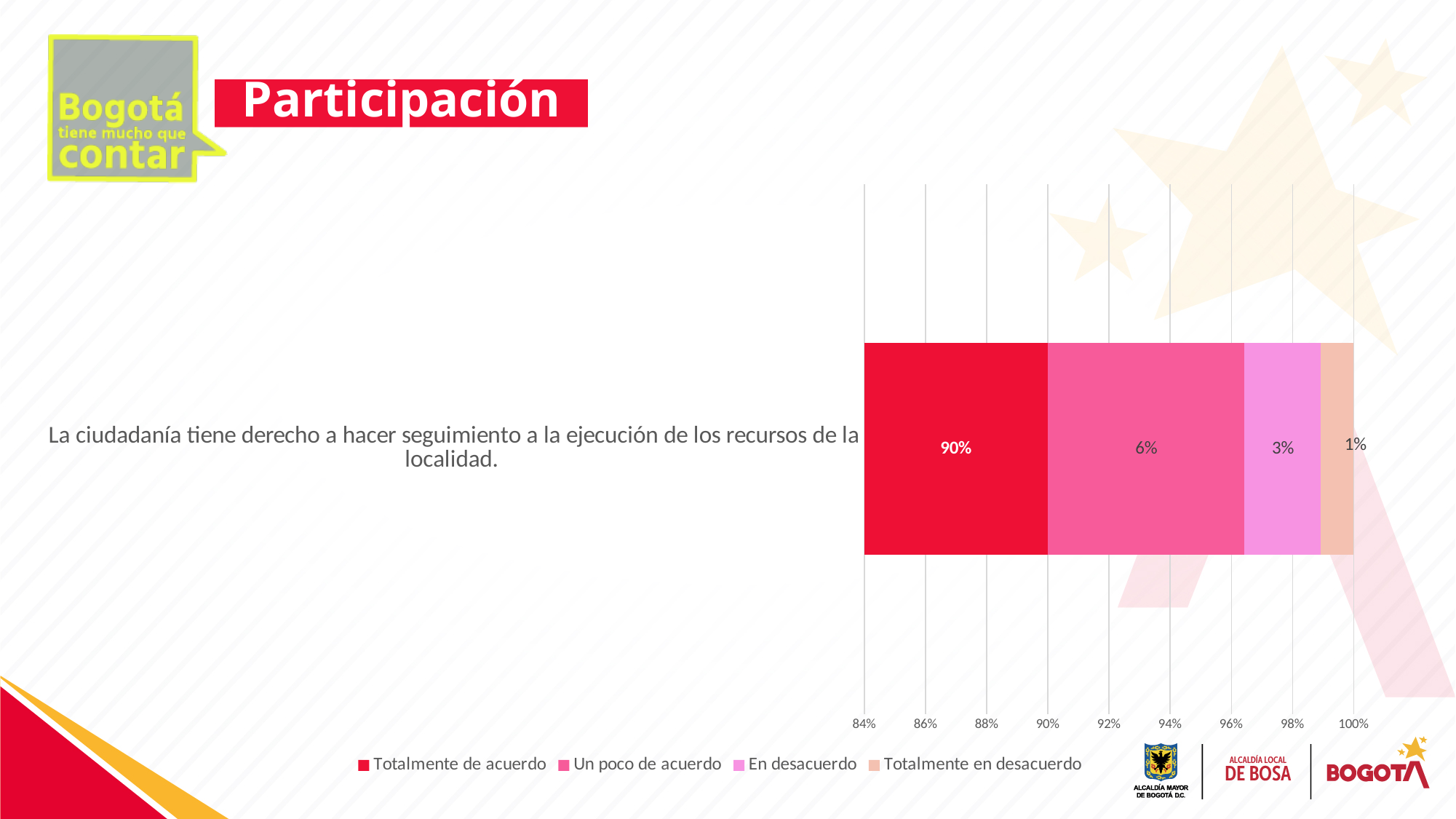
What is the difference between the "Totalmente de acuerdo" share and the "Un poco de acuerdo" share? 84% What percentage of respondents answered "En desacuerdo"? 3% How many series does the legend list? 4 Which response category has the lowest share? Totalmente en desacuerdo Which is larger, the share for "Un poco de acuerdo" or the share for "En desacuerdo"? Un poco de acuerdo What kind of chart is shown on the slide? Stacked bar chart What percentage of respondents answered "Un poco de acuerdo"? 6% What colour represents "Totalmente de acuerdo" in the chart? Red What percentage of respondents answered "Totalmente de acuerdo" to the statement "La ciudadanía tiene derecho a hacer seguimiento a la ejecución de los recursos de la localidad"? 90% What is the combined share of "En desacuerdo" and "Totalmente en desacuerdo"? 4% Which response category has the highest share? Totalmente de acuerdo What percentage of respondents answered "Totalmente en desacuerdo"? 1%